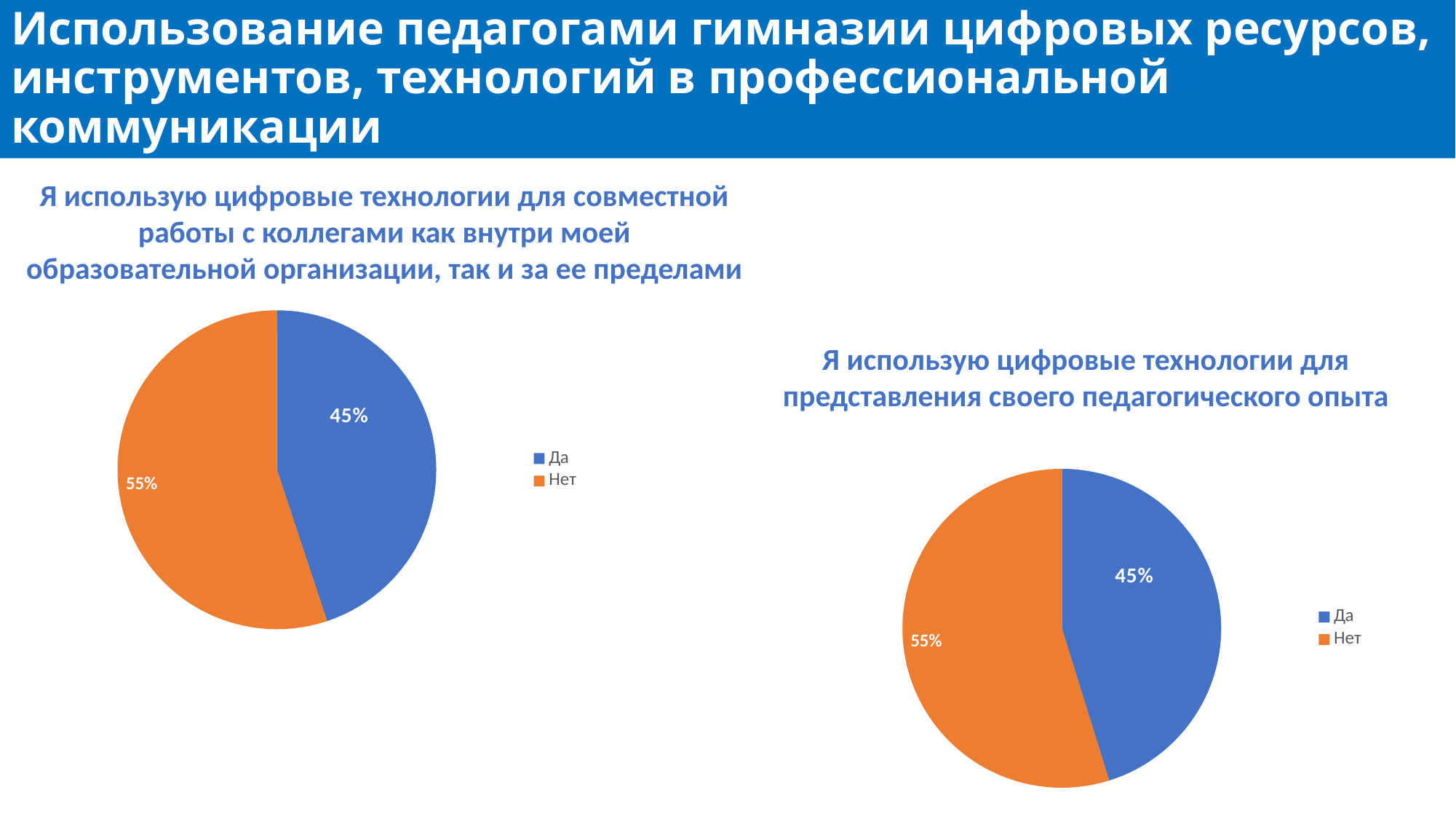
In the right pie chart, which is larger: the "Да" slice or the "Нет" slice? Нет What type of chart is the chart on the left of the slide? Pie chart In the right pie chart (about presenting one's pedagogical experience), what share is labelled for "Да"? 45% In the right pie chart, what colour is the "Нет" slice? Orange In the left pie chart (about using digital technologies for collaborative work with colleagues), what share is labelled for "Да"? 45% In the left pie chart, what is the difference in percentage points between the "Нет" and "Да" slices? 10 percentage points How many slices does the right pie chart have? 2 In the left pie chart (about collaborative work with colleagues), what share is labelled for "Нет"? 55% In the right pie chart, which slice is the smallest? Да In the right pie chart (about presenting one's pedagogical experience), what share is labelled for "Нет"? 55% How many entries does the legend of the left pie chart list? 2 In the left pie chart, which slice is the largest? Нет